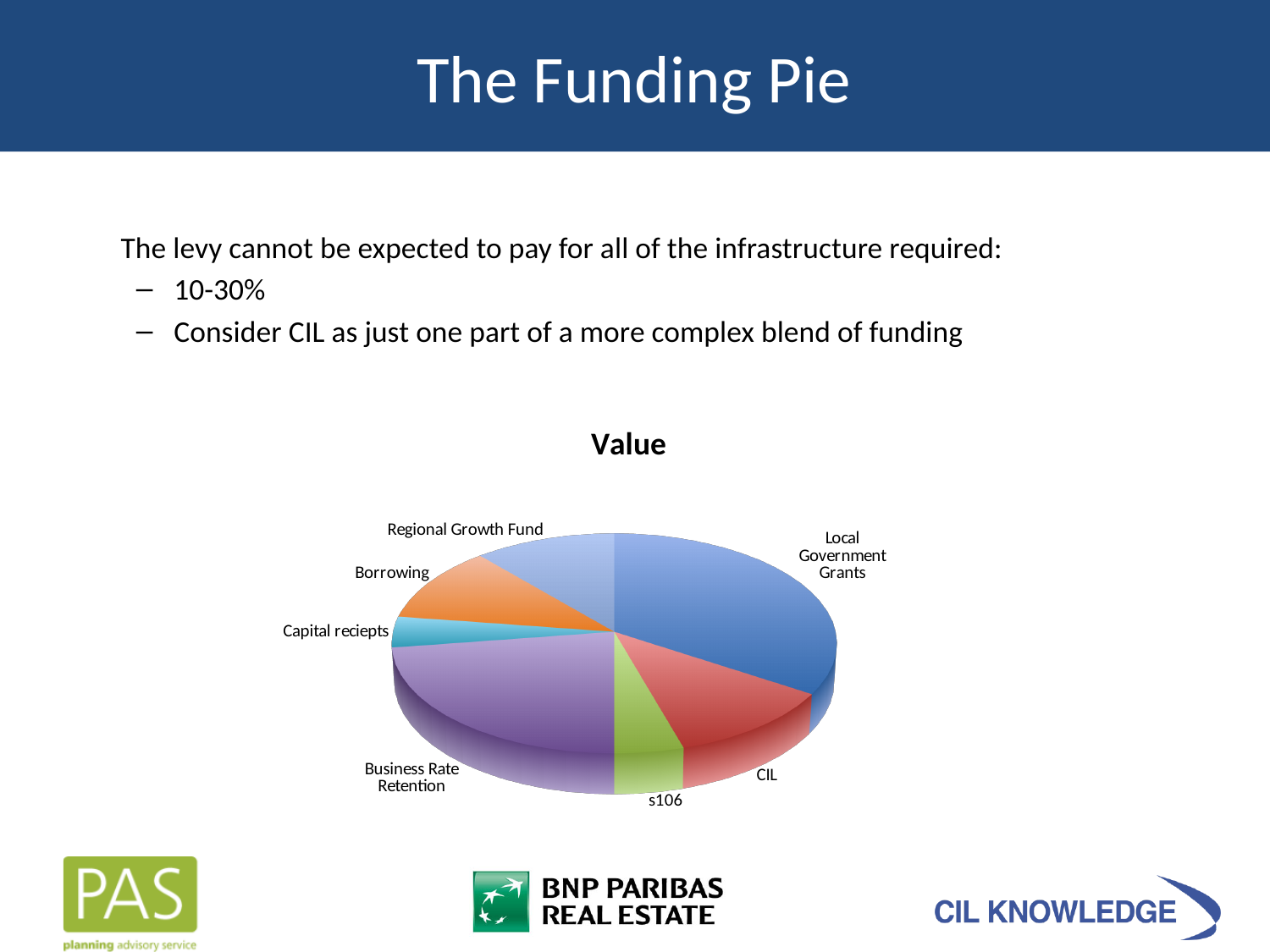
Which slice is larger, Business Rate Retention or Regional Growth Fund? Business Rate Retention Which slice is larger, Local Government Grants or s106? Local Government Grants Which slice is larger, CIL or s106? CIL What colour is the CIL slice of the pie? red What is the title of the pie chart? Value Which category has the largest slice of the pie? Local Government Grants What kind of chart is shown on the slide? pie chart How many slices does the pie chart have? 7